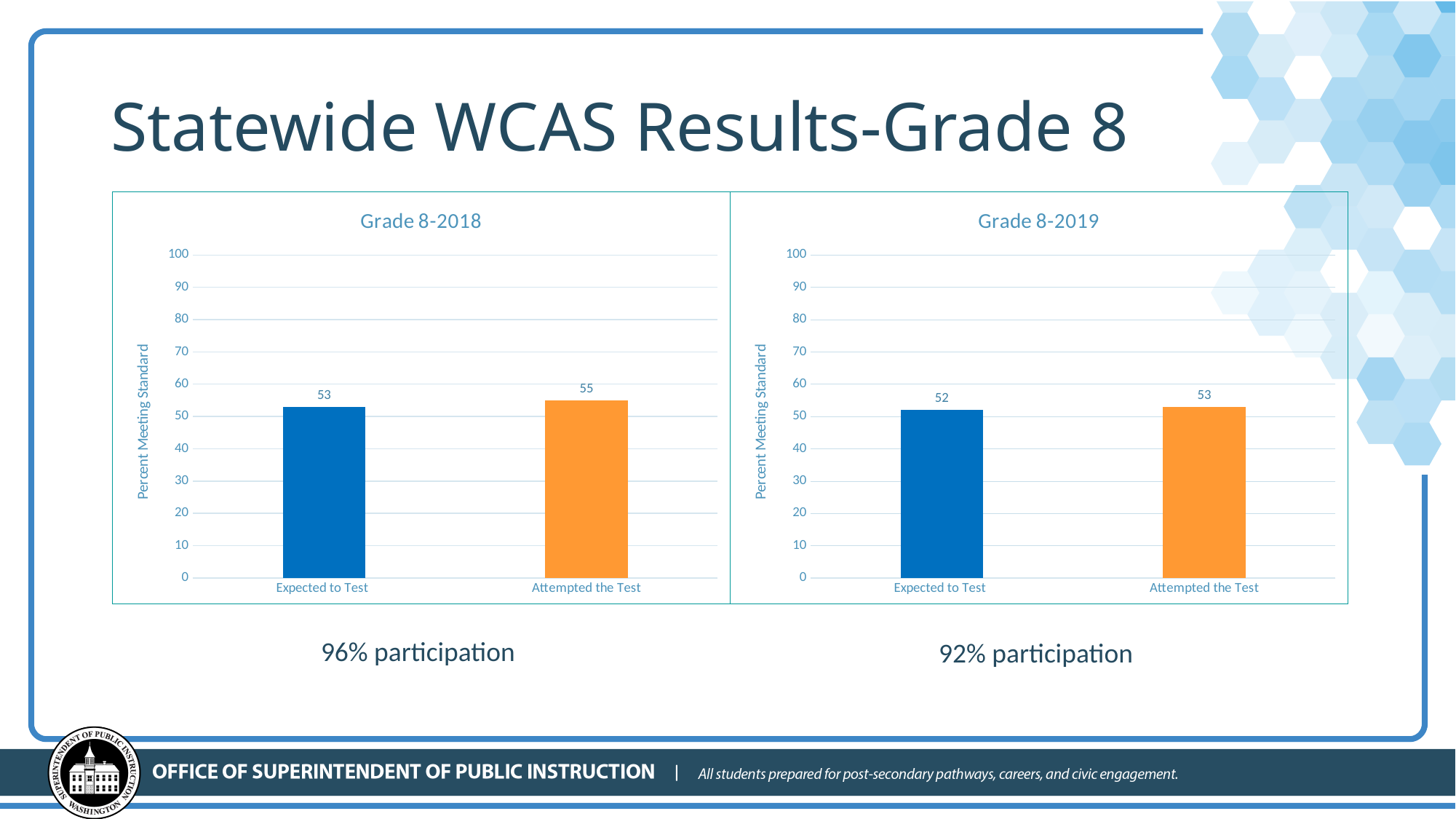
In the Grade 8-2018 chart, which category has the higher value? Attempted the Test In the Grade 8-2019 chart, what is the value for Attempted the Test? 53 In the Grade 8-2018 chart, what is the value for Expected to Test? 53 In the Grade 8-2018 chart, what is the difference between Attempted the Test and Expected to Test? 2 In the Grade 8-2019 chart, which category has the lower value? Expected to Test In the Grade 8-2019 chart, what is the difference between Attempted the Test and Expected to Test? 1 In the Grade 8-2019 chart, what is the value for Expected to Test? 52 Is the value for Expected to Test in the Grade 8-2019 chart greater or less than 60? less In the Grade 8-2018 chart, what is the value for Attempted the Test? 55 What kind of chart is the Grade 8-2019 chart? Bar chart How many categories are shown in the Grade 8-2018 chart? 2 What is the y-axis label of the Grade 8-2018 chart? Percent Meeting Standard